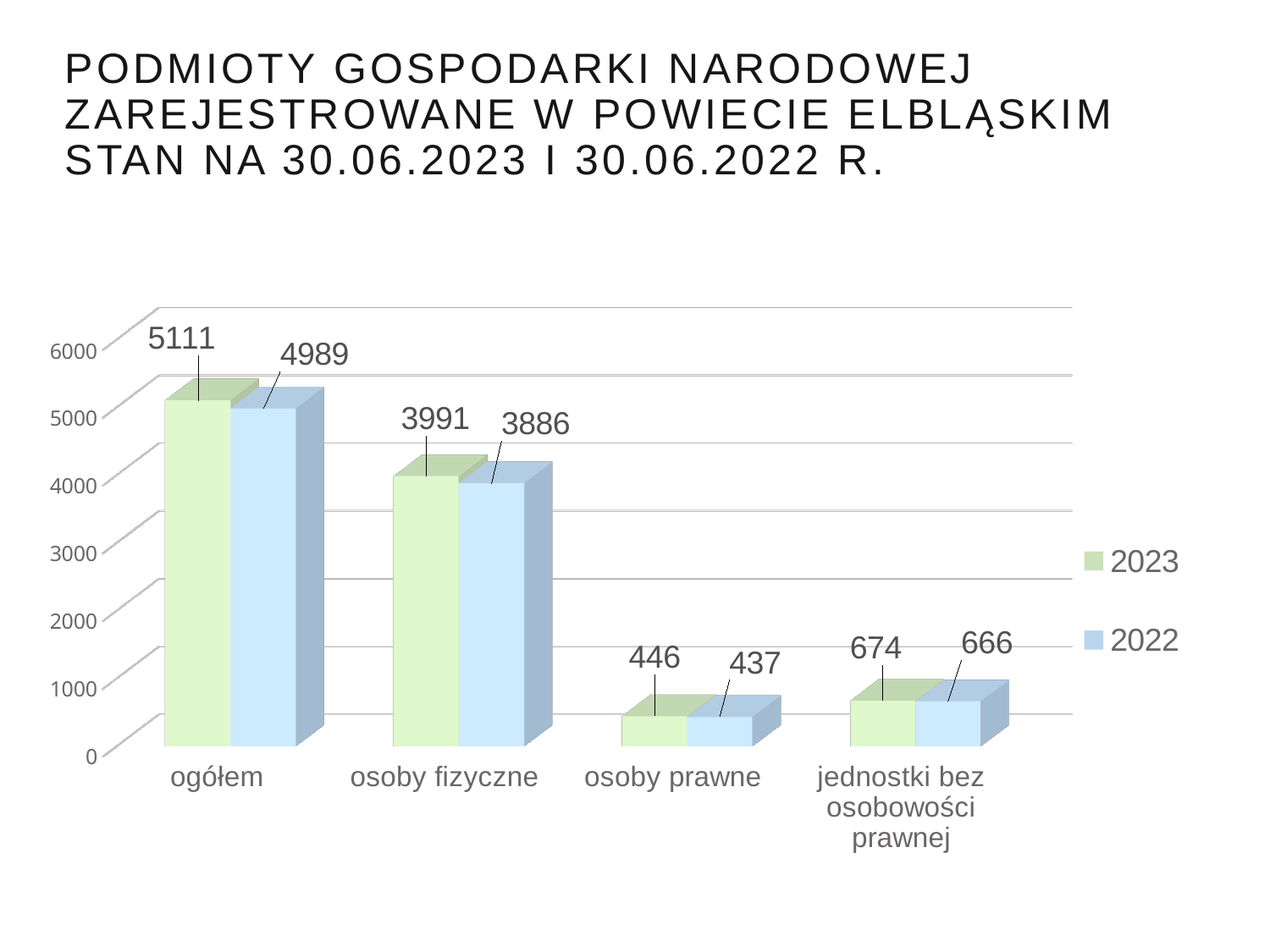
What kind of chart is shown on the slide? bar chart Which category has the lowest value in 2022? osoby prawne What is the difference between the 2023 and 2022 values for osoby fizyczne? 105 What is the difference between the 2023 and 2022 values for ogółem? 122 Which is larger for osoby prawne: the 2023 value or the 2022 value? 2023 Which category has the highest value in 2023? ogółem What is the value for osoby prawne in 2023? 446 How many series does the legend list? 2 What is the value for ogółem in 2023? 5111 How many categories are shown on the x axis? 4 What is the value for jednostki bez osobowości prawnej in 2022? 666 What is the value for osoby fizyczne in 2022? 3886